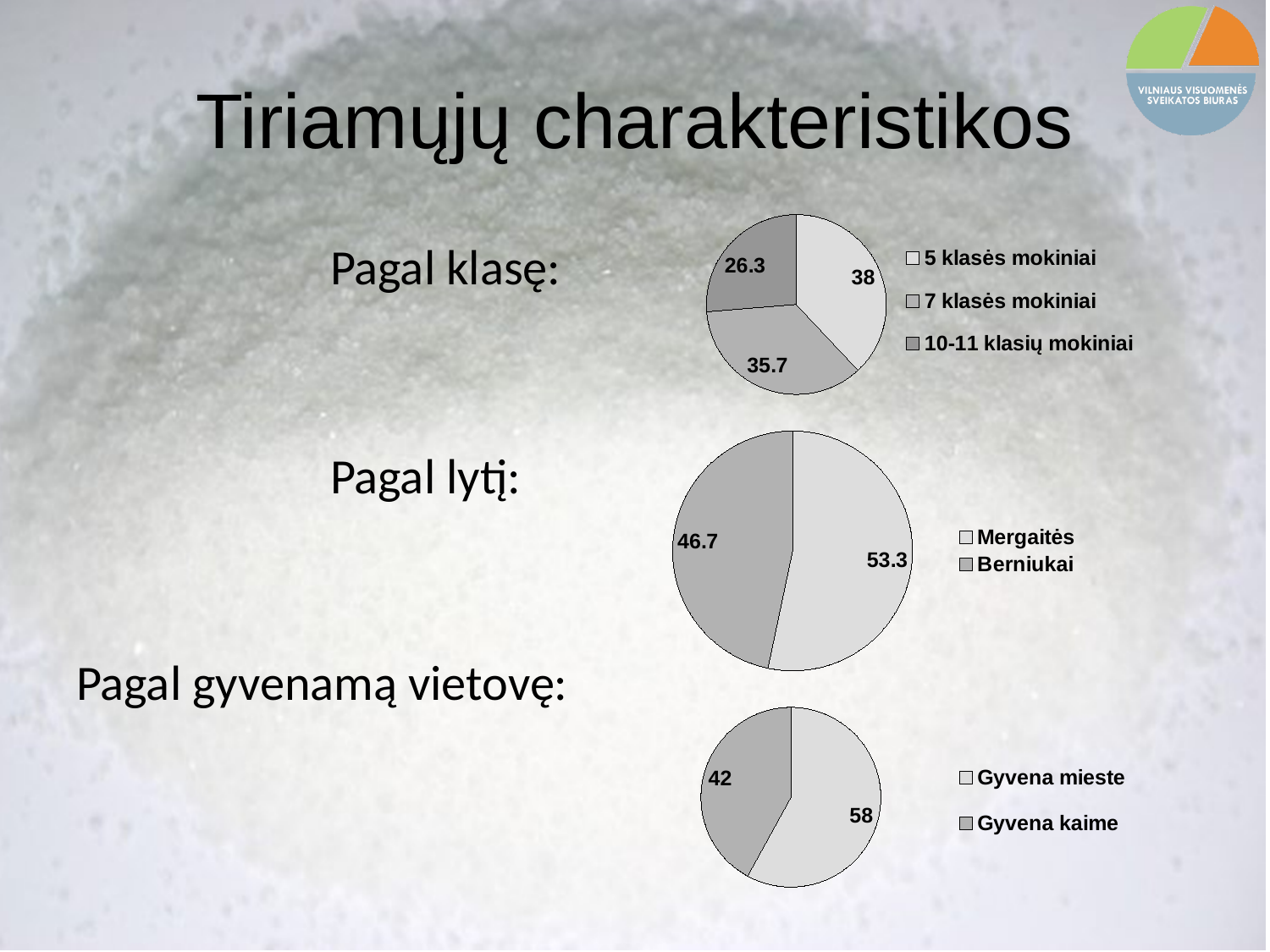
In the top pie chart (Pagal klasę), which category has the smallest slice? 10-11 klasių mokiniai In the bottom pie chart (Pagal gyvenamą vietovę), what is the difference between Gyvena mieste and Gyvena kaime? 16 In the top pie chart (Pagal klasę), what is the value for 10-11 klasių mokiniai? 26.3 In the middle pie chart (Pagal lytį), which is larger, Mergaitės or Berniukai? Mergaitės In the top pie chart (Pagal klasę), what is the difference between the values for 7 klasės mokiniai and 10-11 klasių mokiniai? 9.4 In the middle pie chart (Pagal lytį), what is the value for Berniukai? 46.7 In the top pie chart (Pagal klasę), what is the value for 5 klasės mokiniai? 38 How many categories does the top pie chart (Pagal klasę) show? 3 How many entries does the legend of the middle pie chart (Pagal lytį) list? 2 In the top pie chart (Pagal klasę), which category has the largest slice? 5 klasės mokiniai What type of chart is used for the bottom chart (Pagal gyvenamą vietovę)? Pie chart In the bottom pie chart (Pagal gyvenamą vietovę), what is the value for Gyvena kaime? 42